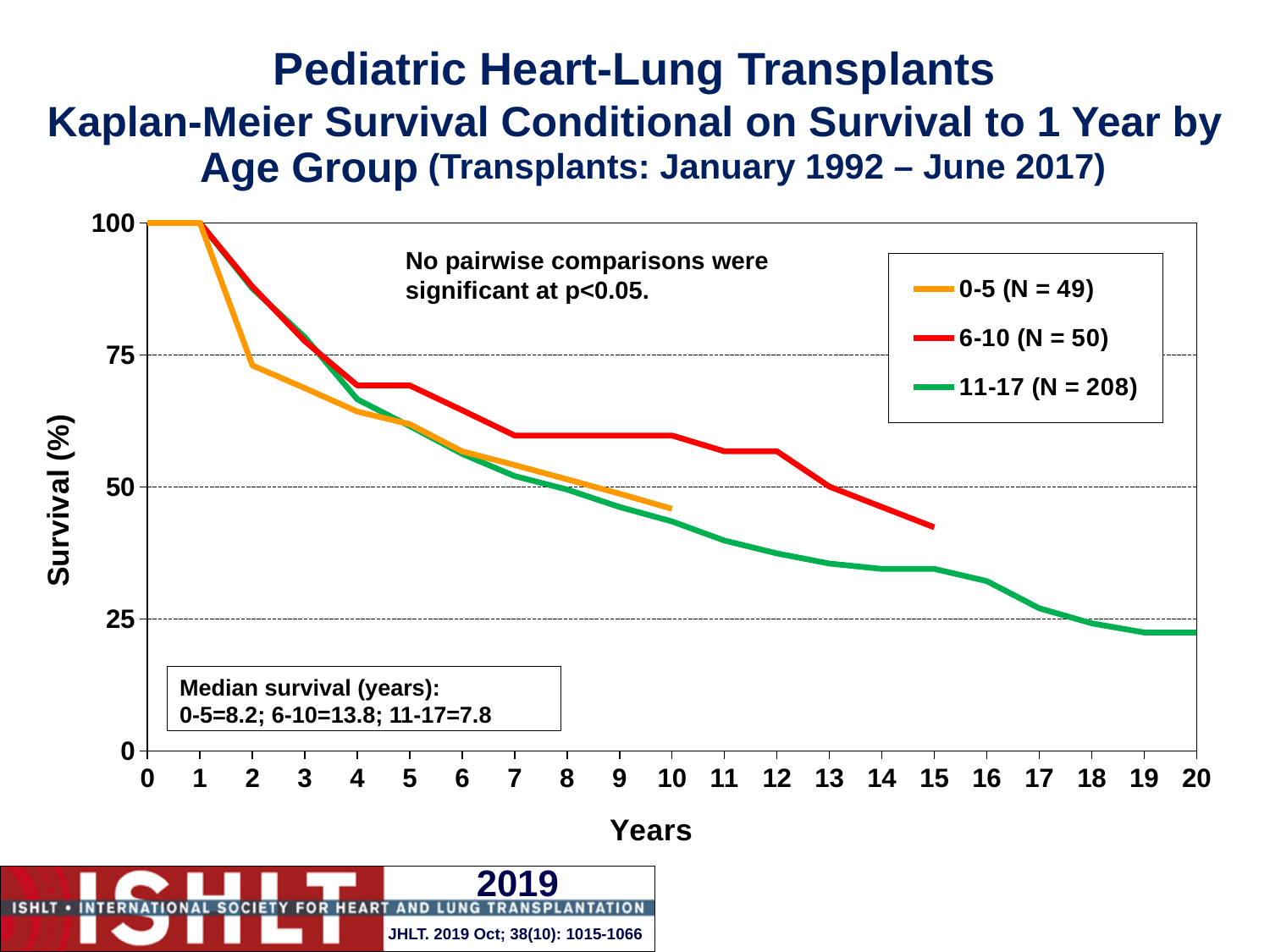
At 15 years, which group has higher survival, 6-10 or 11-17? 6-10 What is the N for the 11-17 age group shown in the legend? 208 Which age group has the highest median survival? 6-10 What is the difference in median survival (years) between the 6-10 and 11-17 age groups? 6.0 Which age group has the lowest median survival? 11-17 How many series does the legend list? 3 What kind of chart is shown on the slide? line chart What is the median survival in years for the 6-10 age group? 13.8 Do the survival curves rise or fall as years increase? fall What is the median survival in years for the 11-17 age group? 7.8 Is the survival value for the 6-10 group at 10 years greater or less than 50? greater Is the survival value for the 11-17 group at 20 years greater or less than 25? less